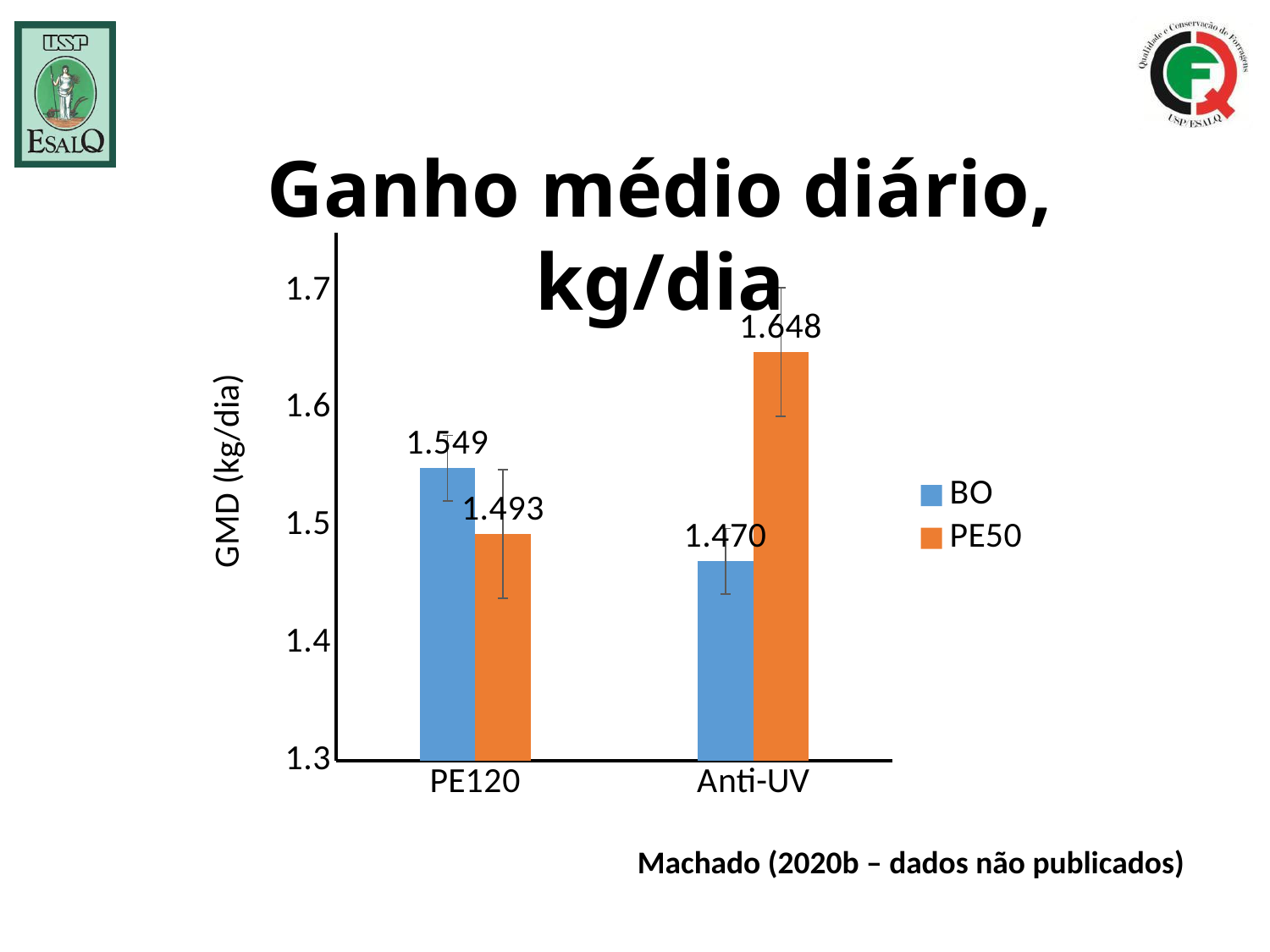
How many series does the legend list? 2 What kind of chart is shown on the slide? Bar chart Which bar has the highest value on the chart? PE50 in Anti-UV What is the value for BO in the PE120 category? 1.549 What is the difference between the BO and PE50 values in the PE120 category? 0.056 What is the value for PE50 in the PE120 category? 1.493 What is the value for PE50 in the Anti-UV category? 1.648 Which bar has the lowest value on the chart? BO in Anti-UV In the PE120 category, which series has the larger value, BO or PE50? BO What is the difference between the PE50 and BO values in the Anti-UV category? 0.178 What is the value for BO in the Anti-UV category? 1.470 How many categories are shown on the x axis? 2